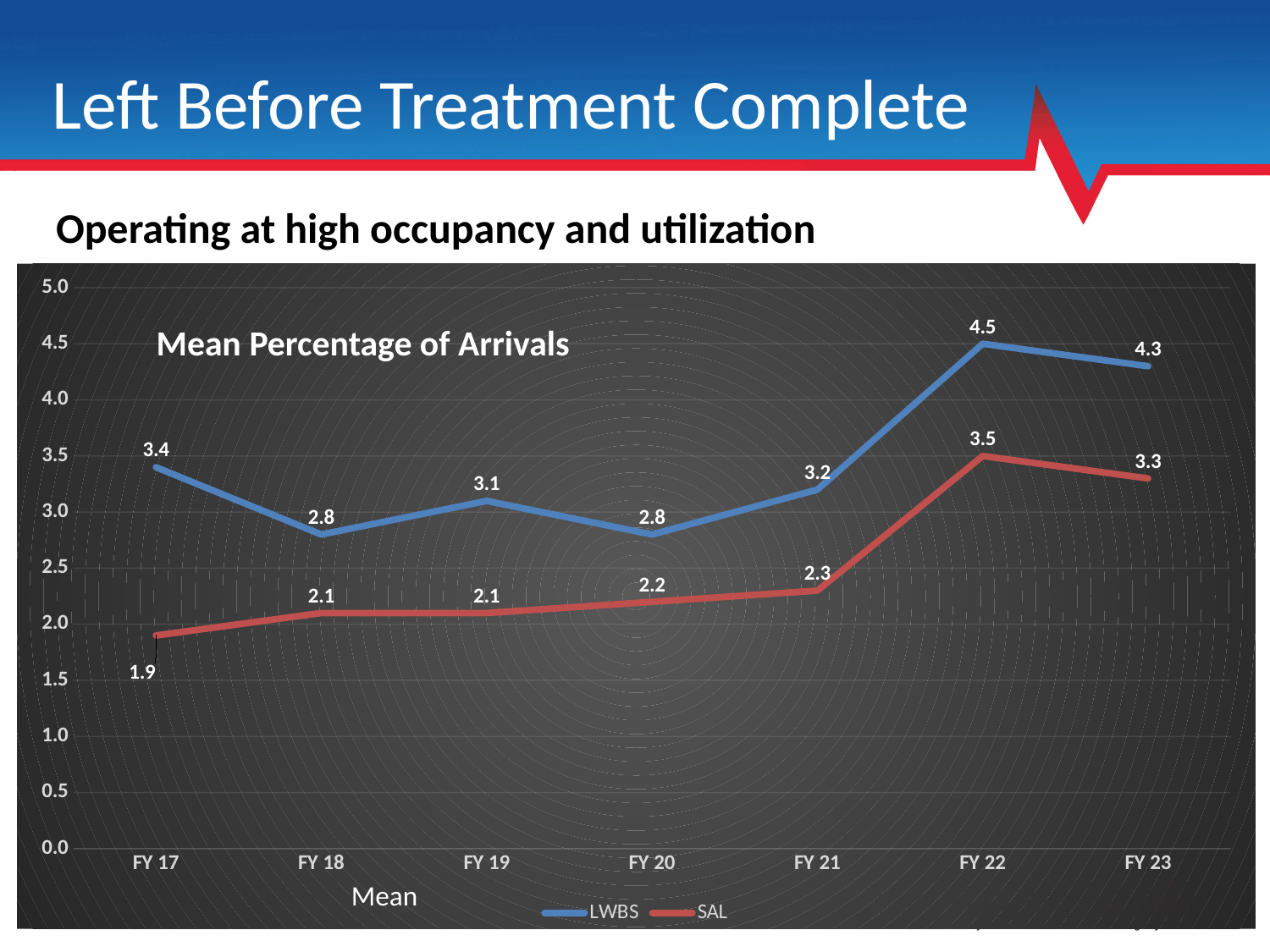
What is the SAL value for FY 23? 3.3 What kind of chart is shown on the slide? Line chart Does the SAL line rise or fall from FY 17 to FY 22? Rise Which is larger in FY 18, the LWBS value or the SAL value? LWBS What is the LWBS value for FY 19? 3.1 How many series does the legend list? 2 What is the difference between the LWBS and SAL values in FY 21? 0.9 How many fiscal years are shown on the x axis? 7 In which fiscal year is the LWBS value highest? FY 22 What is the LWBS value for FY 22? 4.5 In which fiscal year is the SAL value lowest? FY 17 What is the SAL value for FY 17? 1.9